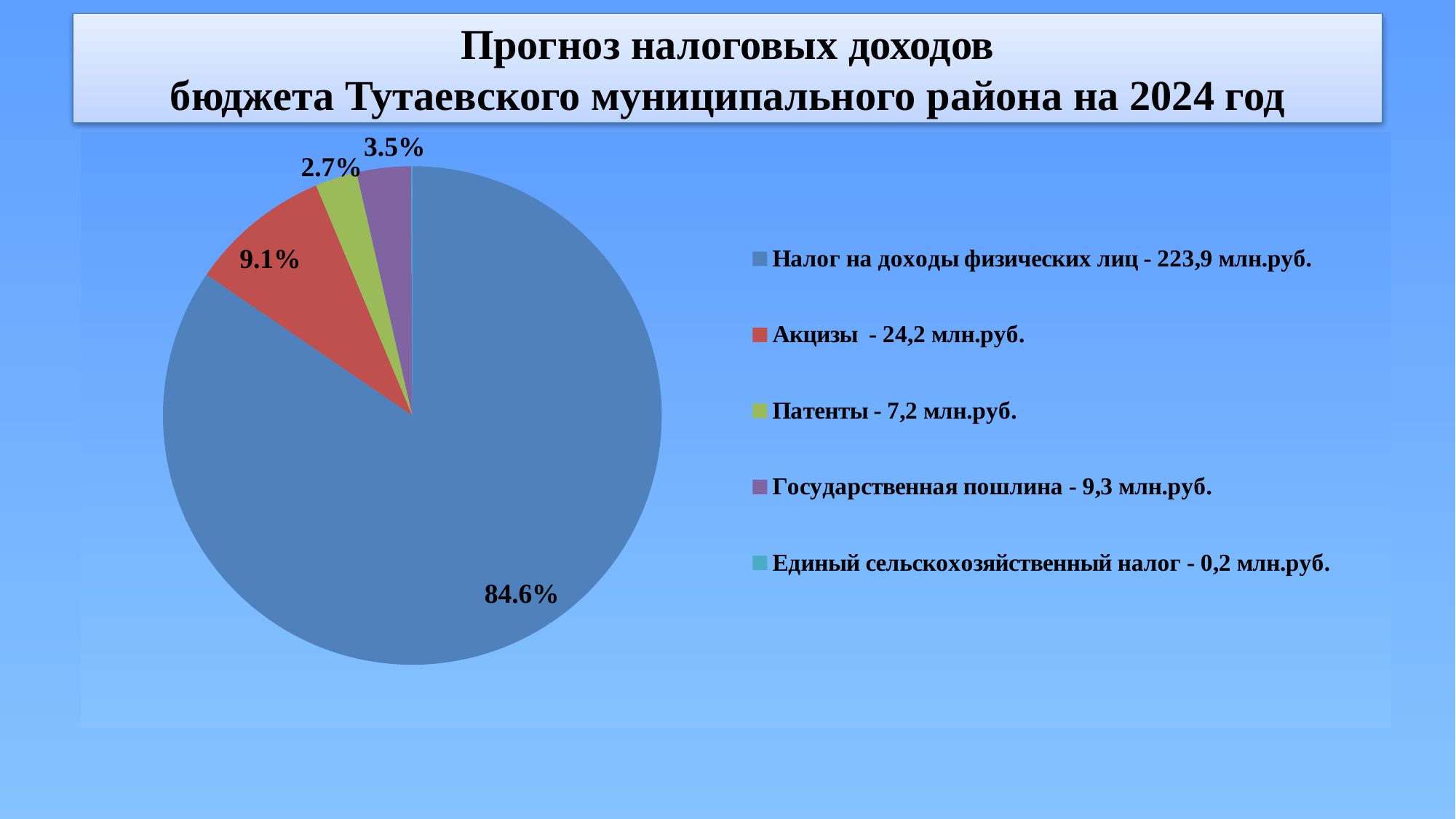
What share of the pie does "Патенты" take? 2.7% What kind of chart is shown on the slide? Pie chart What share of the pie does "Акцизы" take? 9.1% What is the difference in percentage points between the "Налог на доходы физических лиц" slice and the "Акцизы" slice? 75.5 What share of the pie does "Налог на доходы физических лиц" take? 84.6% Which category has the largest slice of the pie? Налог на доходы физических лиц How many categories does the legend list? 5 Which category has the smallest forecast amount in the legend? Единый сельскохозяйственный налог According to the legend, what is the forecast amount for "Акцизы"? 24,2 млн.руб. According to the legend, what is the forecast amount for "Единый сельскохозяйственный налог"? 0,2 млн.руб. Which slice is larger: "Государственная пошлина" or "Патенты"? Государственная пошлина